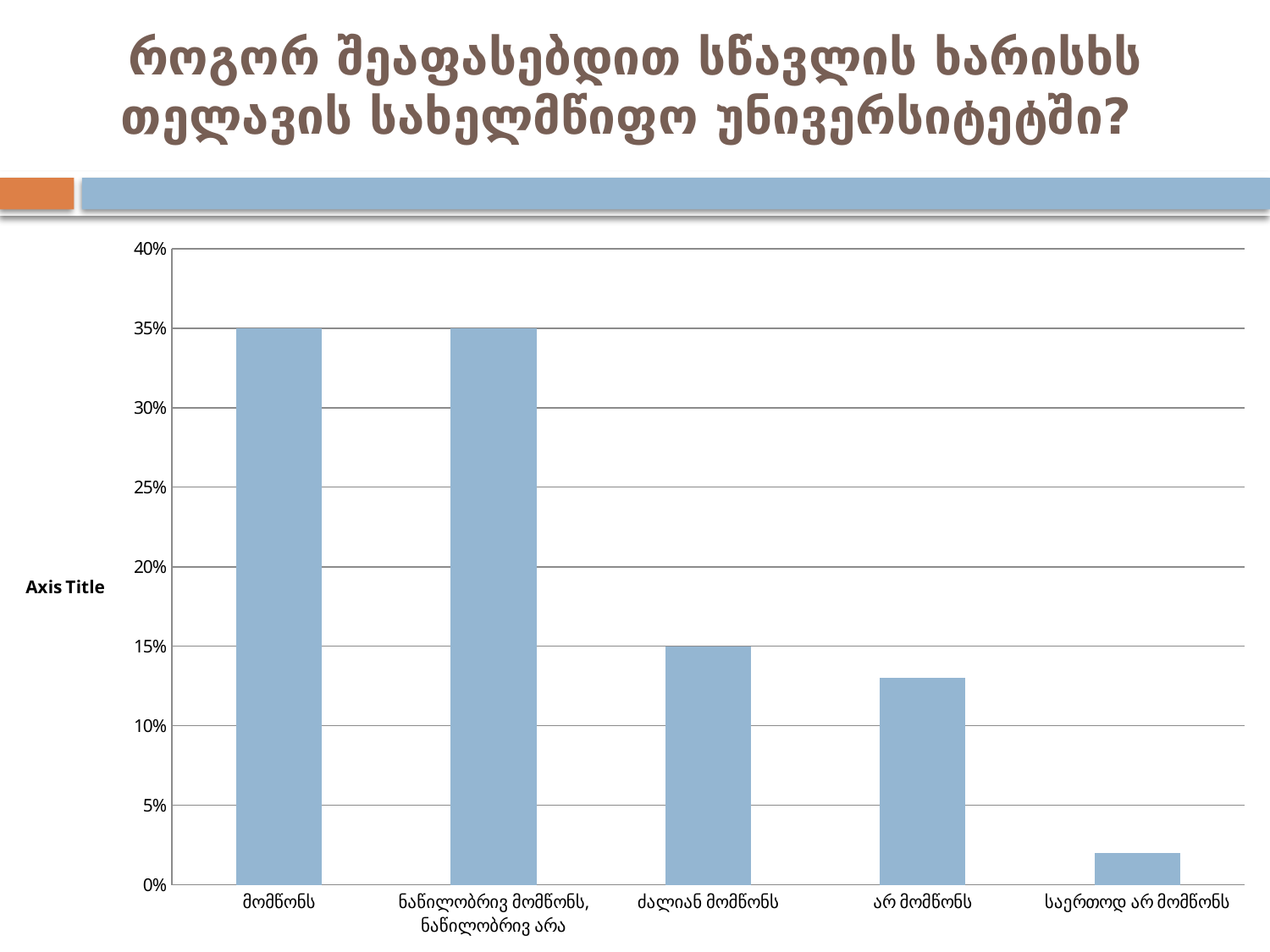
Which is larger, the value for არ მომწონს or the value for საერთოდ არ მომწონს? არ მომწონს What is the title shown on the vertical axis? Axis Title Which is larger, the value for მომწონს or the value for ძალიან მომწონს? მომწონს How many categories are shown on the x axis? 5 What is the difference between the values for მომწონს and ძალიან მომწონს? 20% What is the value for ძალიან მომწონს? 15% Is the value for საერთოდ არ მომწონს greater or less than 5%? less What is the value for ნაწილობრივ მომწონს, ნაწილობრივ არა? 35% What kind of chart is shown on the slide? bar chart What is the value for მომწონს? 35% Is the value for არ მომწონს greater or less than 10%? greater Which category has the lowest value? საერთოდ არ მომწონს